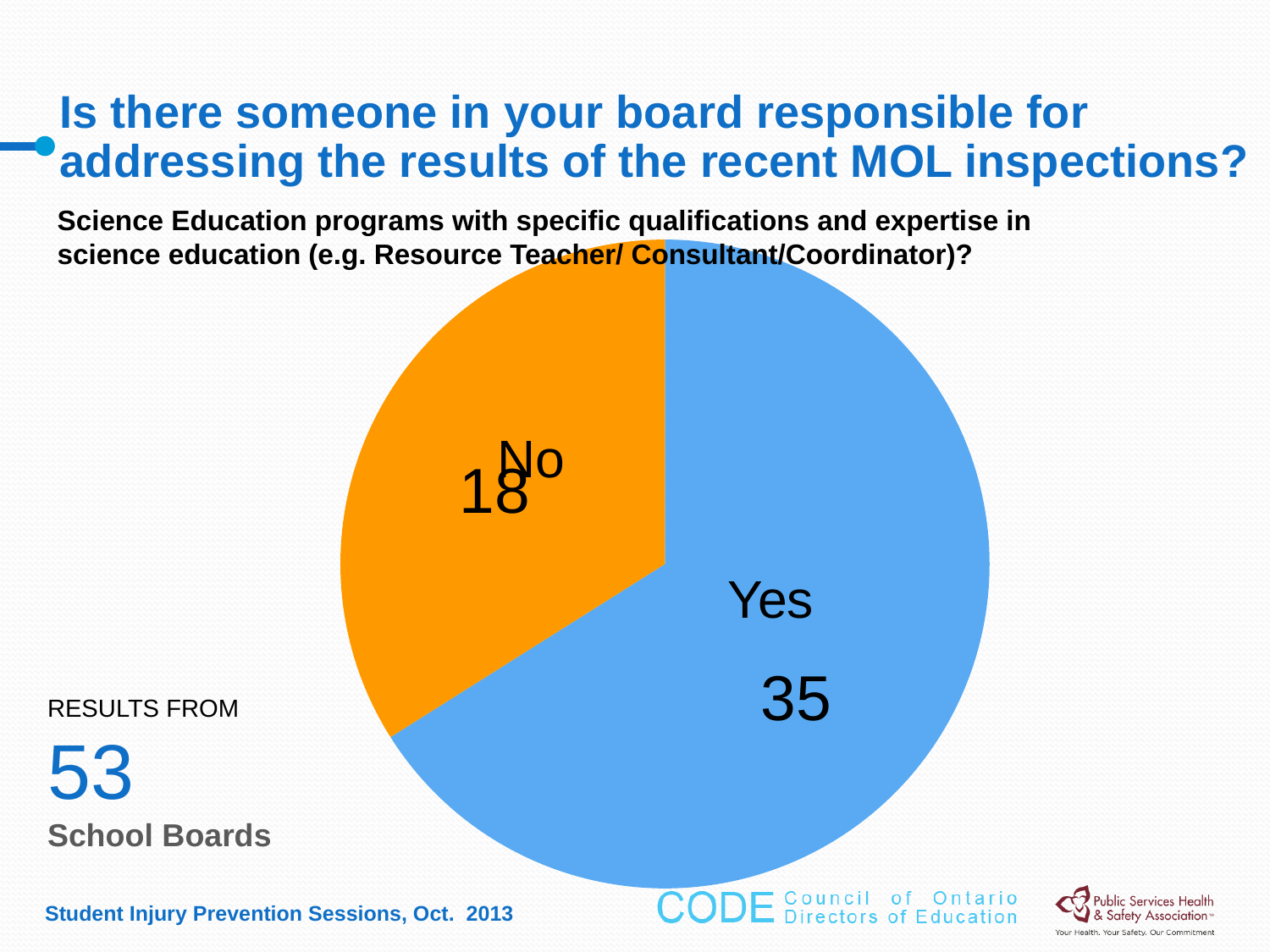
What kind of chart is shown on the slide? pie chart Which response has the larger slice in the pie chart? Yes How many school boards do the results come from, according to the slide? 53 What colour is the No slice of the pie chart? orange What is the difference between the Yes and No counts in the pie chart? 17 What colour is the Yes slice of the pie chart? blue How many boards answered No in the pie chart? 18 Is the value for Yes larger or smaller than the value for No? larger How many boards answered Yes in the pie chart? 35 What is the total of the Yes and No values in the pie chart? 53 How many slices does the pie chart have? 2 Which response has the smaller slice in the pie chart? No